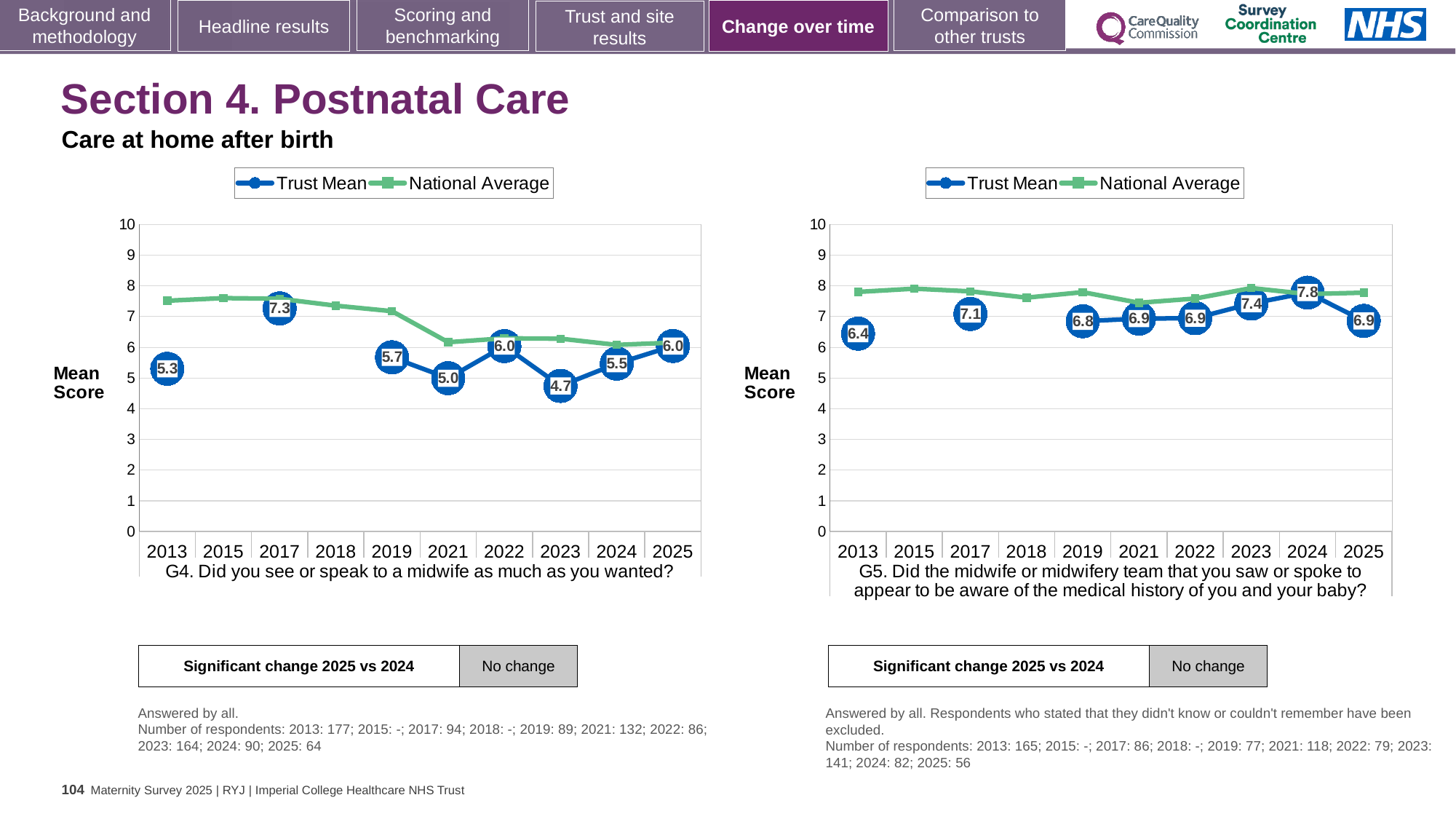
In the G4 chart (left), which year has the highest Trust Mean? 2017 In the G5 chart (right), which is larger, the Trust Mean for 2023 or for 2025? 2023 In the G4 chart (left), is the National Average for 2013 greater or less than 7? greater In the G5 chart (right), what is the Trust Mean for 2024? 7.8 In the G4 chart (left), what is the Trust Mean for 2025? 6.0 How many series does the legend of the G5 chart (right) list? 2 In the G5 chart (right), what is the difference between the Trust Mean in 2024 and in 2025? 0.9 What kind of chart is the G4 chart (left)? Line chart In the G4 chart (left), what is the difference between the Trust Mean in 2017 and in 2021? 2.3 In the G5 chart (right), which year has the lowest Trust Mean? 2013 In the G4 chart (left), what is the Trust Mean for 2023? 4.7 In the G4 chart (left), which year has the lowest Trust Mean? 2023